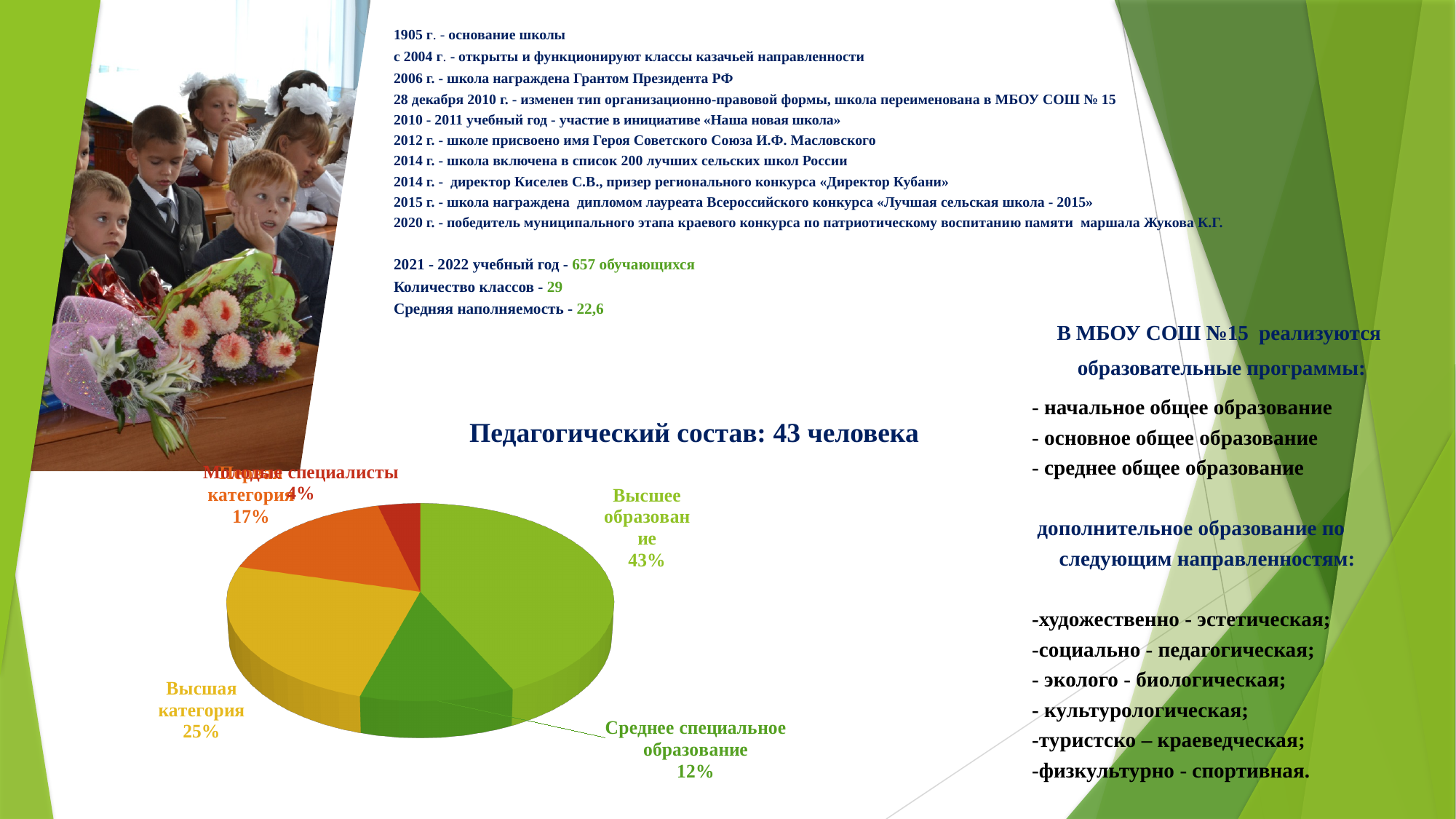
Which is larger in the pie chart: "Высшая категория" or "Среднее специальное образование"? Высшая категория What is the title of the chart on the slide? Педагогический состав: 43 человека By how many percentage points does "Высшая категория" exceed "Молодые специалисты"? 21 percentage points What percentage does the slice labelled "Среднее специальное образование" show? 12% What percentage is shown for "Молодые специалисты"? 4% By how many percentage points does "Высшее образование" exceed "Среднее специальное образование"? 31 percentage points Which slice of the pie chart has the largest share? Высшее образование How many slices does the pie chart have? 5 What percentage does the slice labelled "Высшее образование" show in the pie chart? 43% What percentage is shown for "Высшая категория" in the pie chart? 25% What type of chart is shown on the slide? Pie chart Which slice of the pie chart has the smallest share? Молодые специалисты